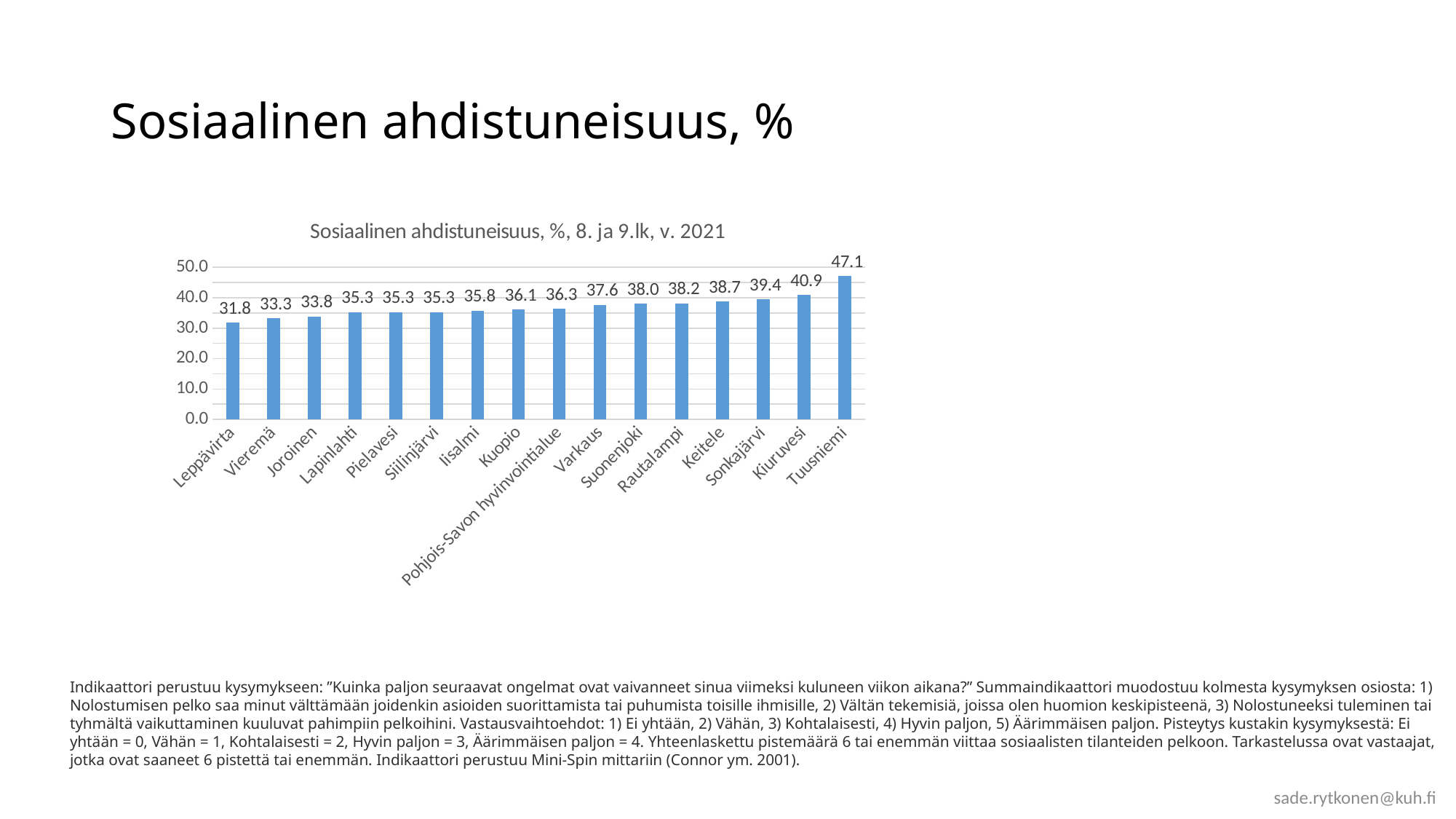
How many categories are shown on the x axis? 16 What is the difference between the values for Tuusniemi and Leppävirta? 15.3 What is the difference between the values for Kiuruvesi and Varkaus? 3.3 Do the values rise or fall from left to right along the x axis? Rise Is the value for Tuusniemi greater or less than 40.0? greater What is the value for Kuopio? 36.1 What is the value for Kiuruvesi? 40.9 Which category has the highest value? Tuusniemi Which is larger, the value for Sonkajärvi or the value for Iisalmi? Sonkajärvi What kind of chart is shown on the slide? Bar chart Which category has the lowest value? Leppävirta What is the value for Pohjois-Savon hyvinvointialue? 36.3